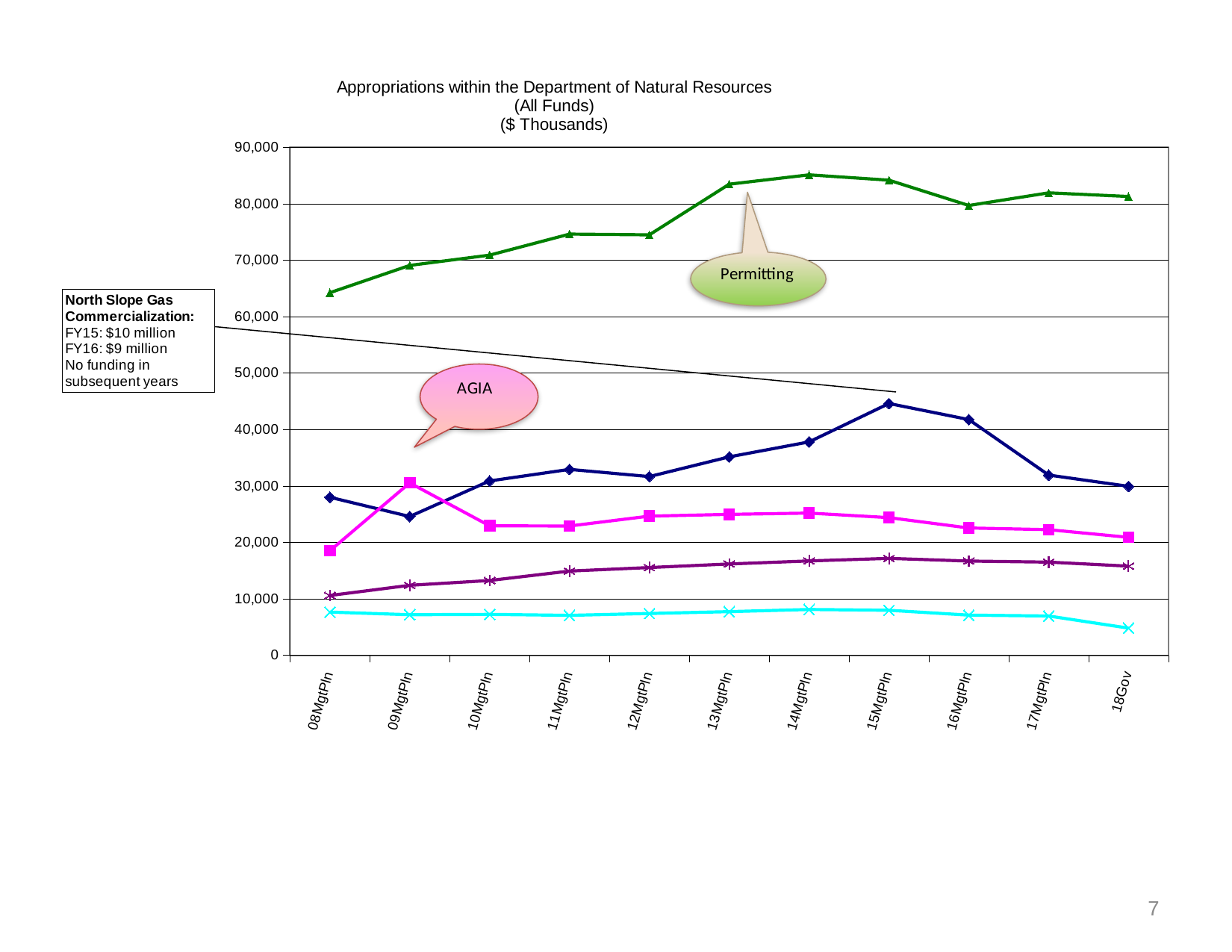
Is the AGIA value for 09MgtPln greater or less than 25,000? greater What is the title of the chart? Appropriations within the Department of Natural Resources (All Funds) ($ Thousands) In which category is the Permitting line at its lowest? 08MgtPln What kind of chart is shown on the slide? line chart Is the Permitting value for 08MgtPln greater or less than 70,000? less How many categories are shown along the x axis? 11 Does the Permitting line rise or fall from 08MgtPln to 14MgtPln? rise In which category is the AGIA line at its highest? 09MgtPln Which line does the green callout label? Permitting Is the Permitting value for 13MgtPln greater or less than 80,000? greater At 08MgtPln, which is larger: the Permitting value or the AGIA value? Permitting How many lines are plotted on the chart? 5